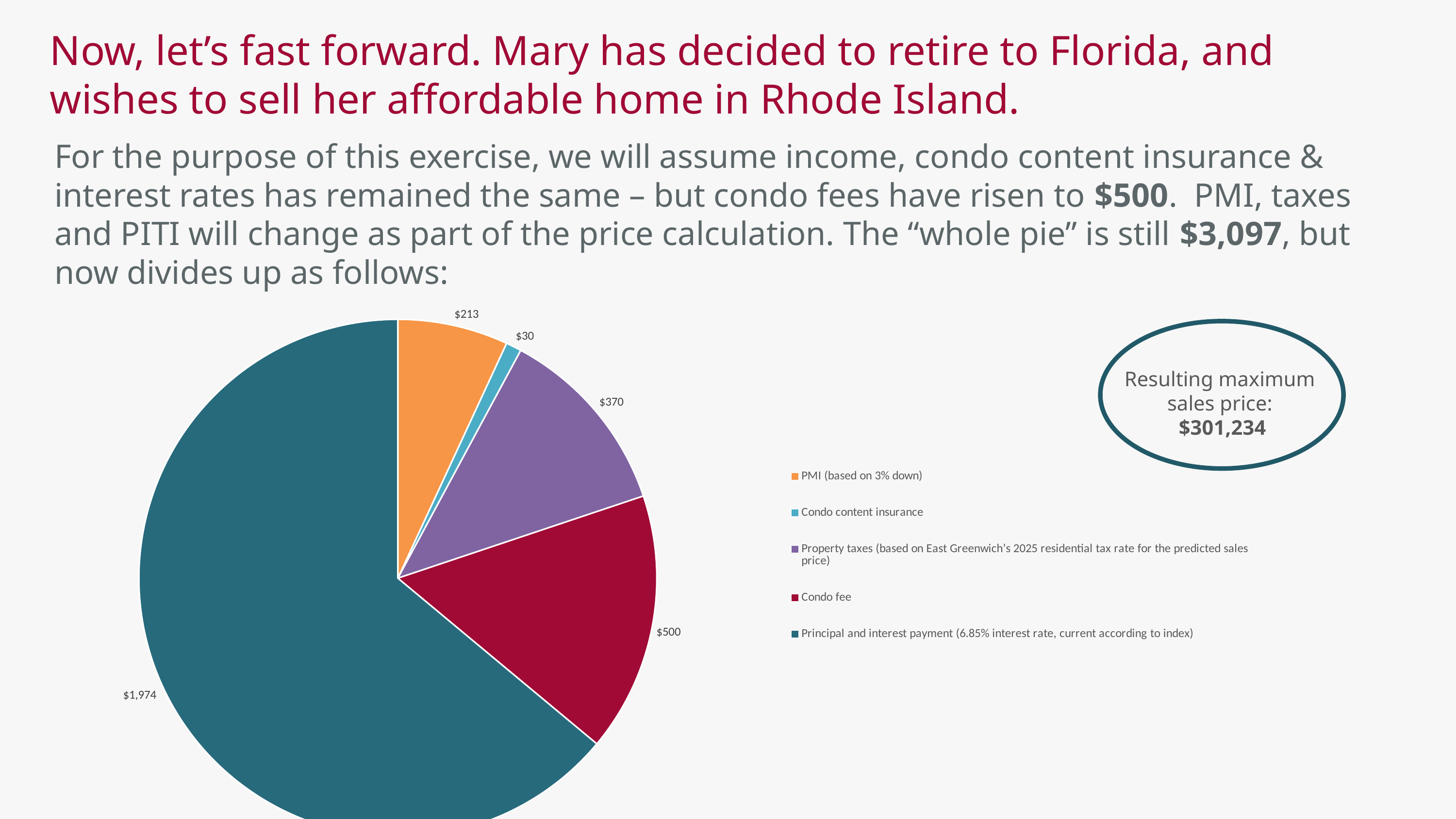
Which category has the smallest slice of the pie? Condo content insurance What is the value of the Condo content insurance slice? $30 What is the difference between the Condo fee and the Property taxes values? $130 What is the value of the Principal and interest payment slice? $1,974 What kind of chart is shown on the slide? pie chart Which category has the largest slice of the pie? Principal and interest payment What is the value of the Condo fee slice? $500 What is the value of the Property taxes slice? $370 Which is larger, the PMI slice or the Property taxes slice? Property taxes What colour is the Condo fee slice? dark red What is the value of the PMI (based on 3% down) slice? $213 How many slices does the pie chart have? 5